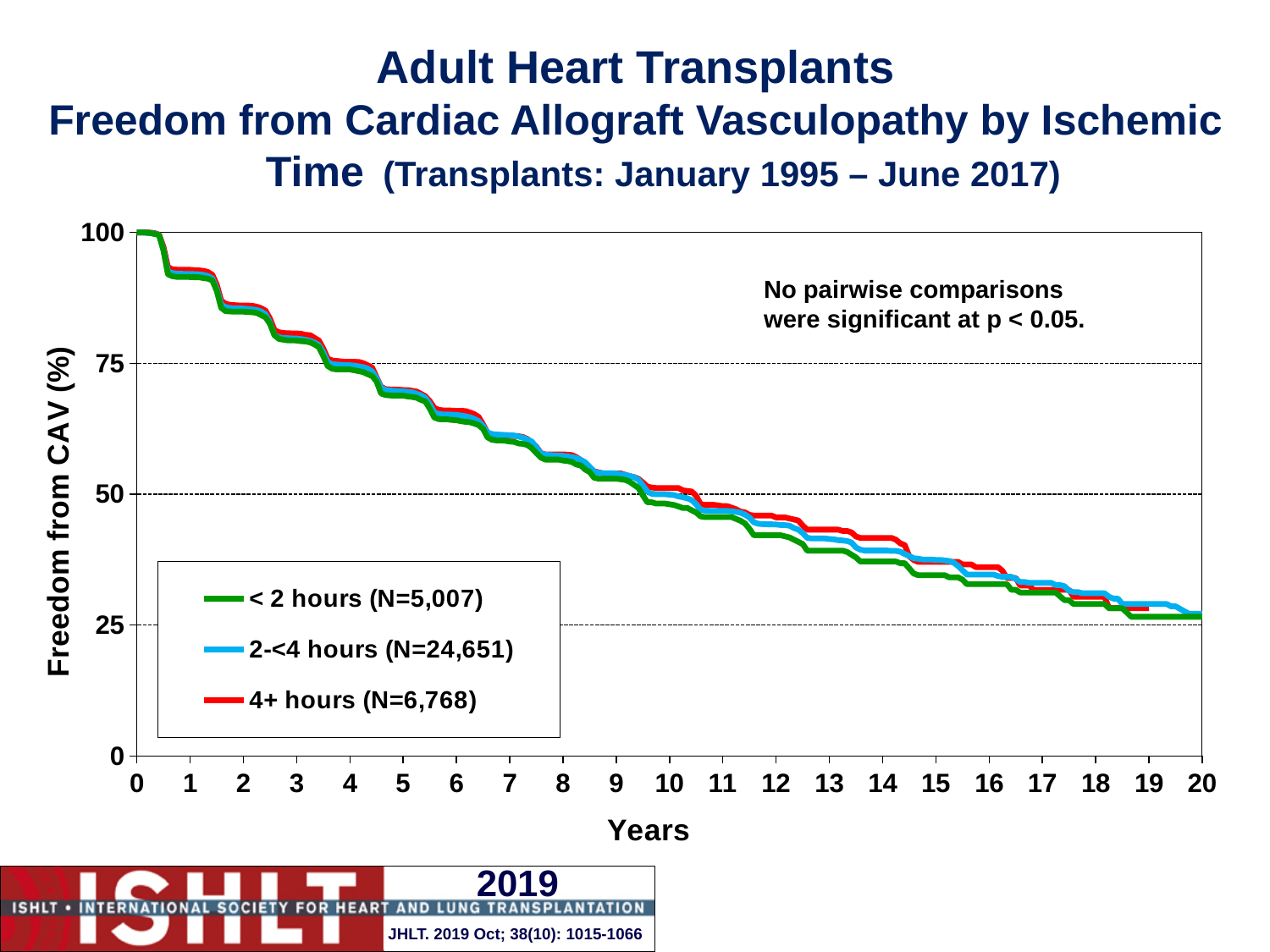
Is the value for the 4+ hours group at year 7 greater or less than 75? less Is the value for the < 2 hours group at year 12 greater or less than 50? less Which ischemic time group has the largest N in the legend? 2-<4 hours Is the value for the < 2 hours group at year 5 greater or less than 50? greater What is the N for the 2-<4 hours group shown in the legend? 24,651 How many series does the legend list? 3 What colour is the line for the 4+ hours group? red What is the label of the y axis? Freedom from CAV (%) What kind of chart is shown on the slide? line chart Do the freedom from CAV values rise or fall as years increase? fall